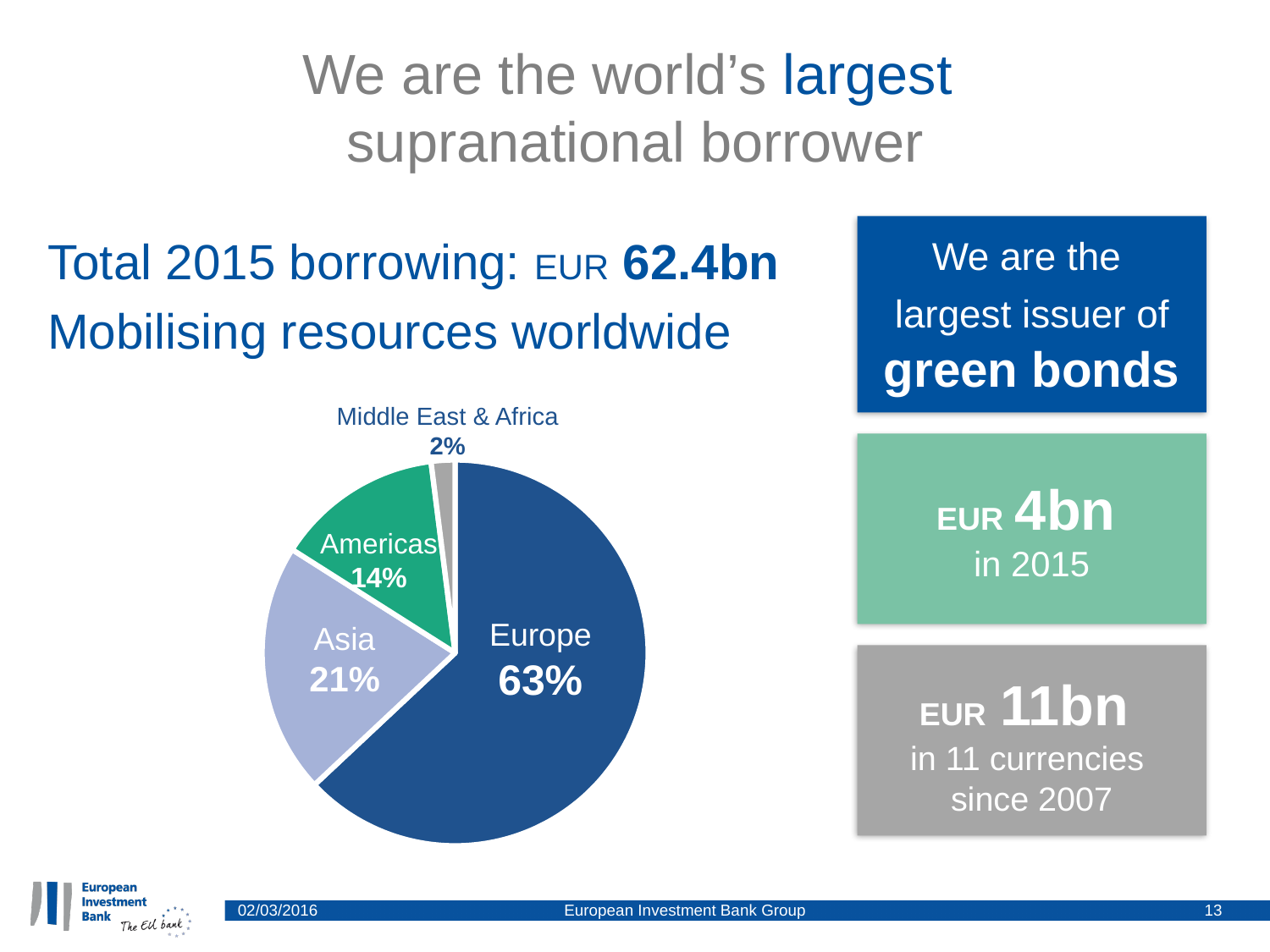
Which region has the largest slice of the pie chart? Europe What is the combined share of Asia and Americas in the pie chart? 35% What share of 2015 borrowing does the Europe slice represent in the pie chart? 63% What type of chart is used to show the regional breakdown of 2015 borrowing? Pie chart Which region has the smallest slice of the pie chart? Middle East & Africa What colour is the Europe slice in the pie chart? Dark blue Which slice is larger, Asia or Americas? Asia What percentage is shown for the Americas in the pie chart? 14% What percentage is shown for Middle East & Africa in the pie chart? 2% How many regions are shown in the pie chart? 4 What percentage is shown for Asia in the pie chart? 21% What is the difference in percentage points between the Europe and Asia slices? 42